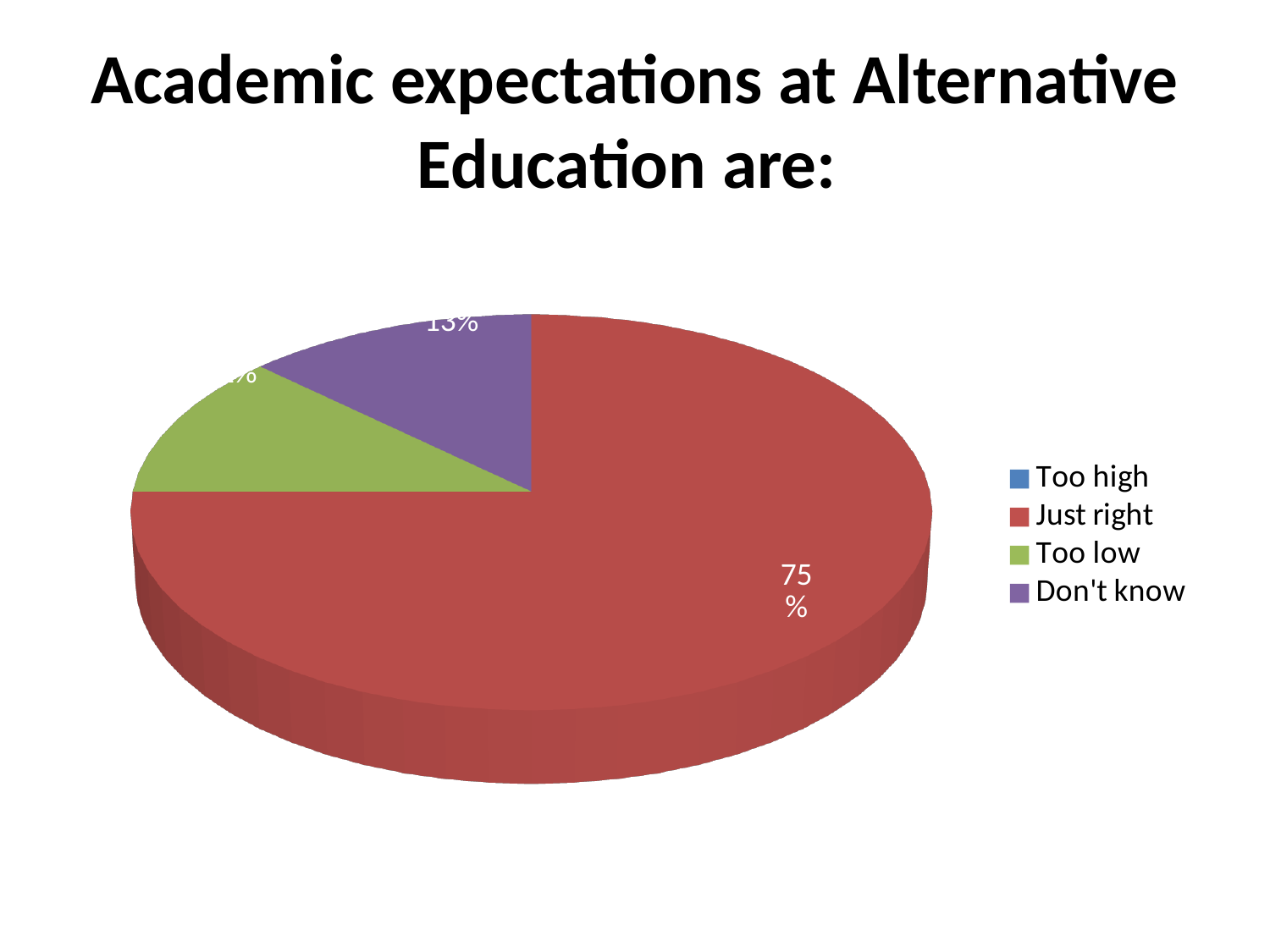
By how many percentage points does the 'Just right' slice exceed the 'Don't know' slice? 62 percentage points Which slice is larger, 'Just right' or 'Don't know'? Just right What percentage of the pie is labelled for the 'Just right' slice? 75% What percentage is shown for the 'Don't know' slice? 13% How many categories does the legend list? 4 What colour represents the 'Just right' category in the legend? Red Which category has the largest slice of the pie? Just right What is the title of the chart? Academic expectations at Alternative Education are: What kind of chart is shown on the slide? Pie chart What share of the pie does the 'Just right' slice represent? 75%